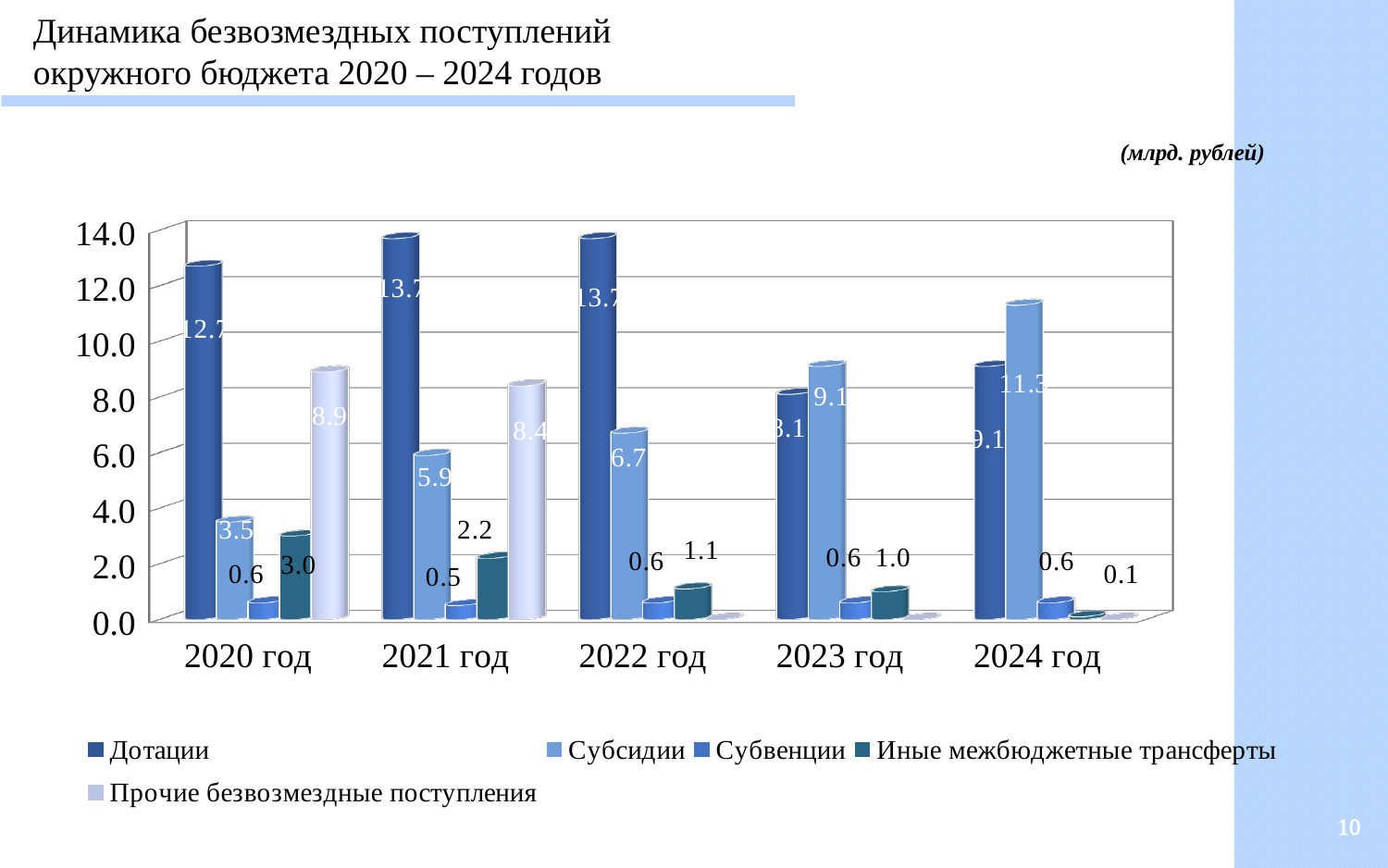
What kind of chart is shown on the slide? Bar chart In which year is the value for Субсидии the highest? 2024 год Do the values for Субсидии rise or fall from 2020 год to 2024 год? Rise What is the value for Иные межбюджетные трансферты in 2022 год? 1.1 What is the difference between Дотации in 2021 год and Дотации in 2020 год? 1.0 What is the value for Прочие безвозмездные поступления in 2021 год? 8.4 Which is larger in 2023 год: Дотации or Субсидии? Субсидии What is the value for Субсидии in 2024 год? 11.3 In which year is the value for Дотации the lowest? 2023 год How many years are shown on the x axis? 5 What is the value for Дотации in 2020 год? 12.7 How many series does the legend list? 5